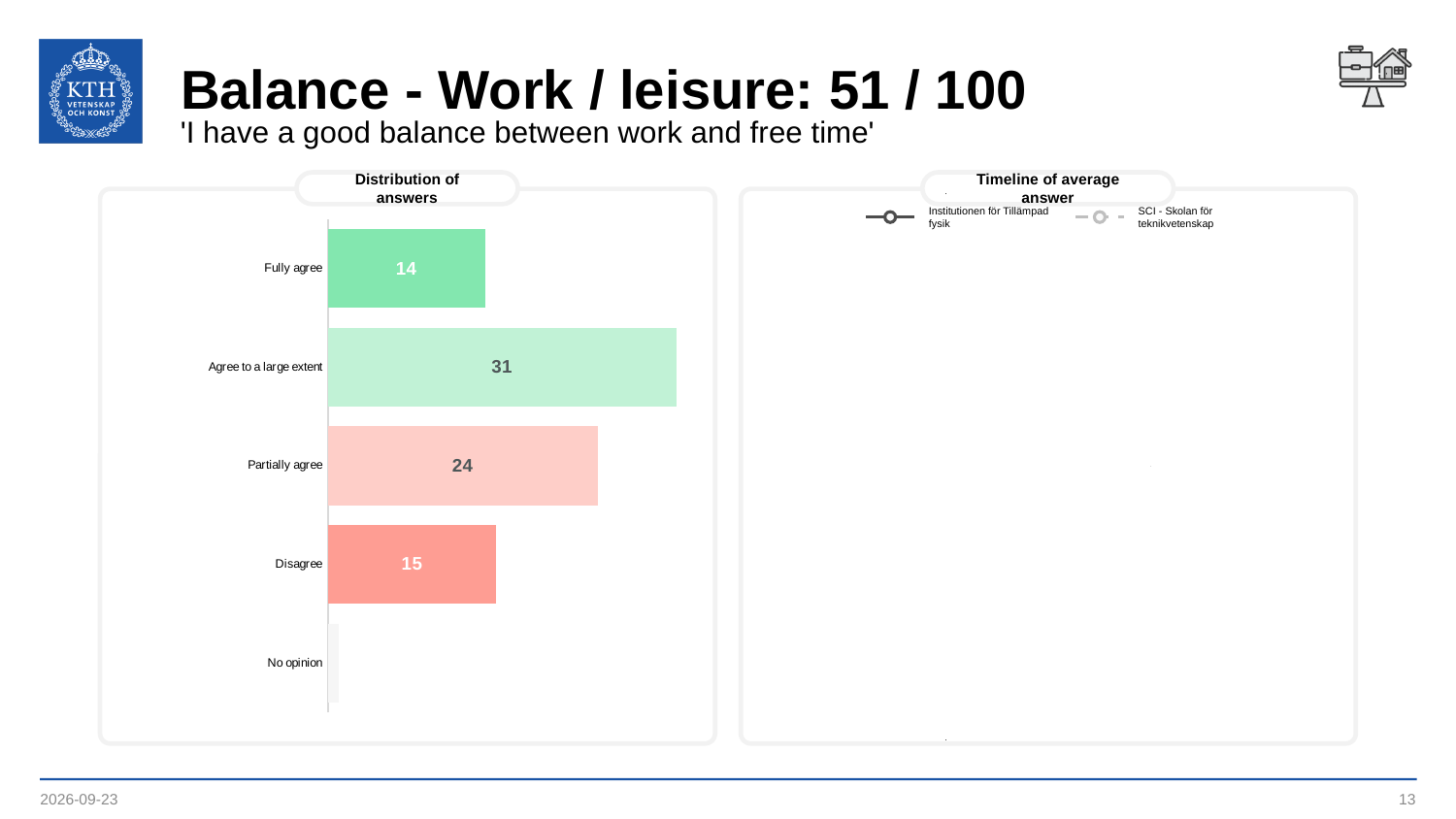
In the 'Distribution of answers' chart, what is the value for 'Agree to a large extent'? 31 In the 'Distribution of answers' chart, what is the difference between 'Partially agree' and 'Disagree'? 9 What kind of chart is the 'Distribution of answers' chart? Bar chart In the 'Distribution of answers' chart, what is the value for 'Disagree'? 15 How many categories are shown in the 'Distribution of answers' chart? 5 In the 'Distribution of answers' chart, which category has the lowest value? No opinion In the 'Distribution of answers' chart, which category has the highest value? Agree to a large extent In the 'Distribution of answers' chart, what is the value for 'Partially agree'? 24 In the 'Distribution of answers' chart, which is larger: 'Fully agree' or 'Disagree'? Disagree In the 'Distribution of answers' chart, what is the value for 'Fully agree'? 14 In the 'Distribution of answers' chart, what is the difference between 'Agree to a large extent' and 'Fully agree'? 17 How many series does the legend of the 'Timeline of average answer' chart list? 2